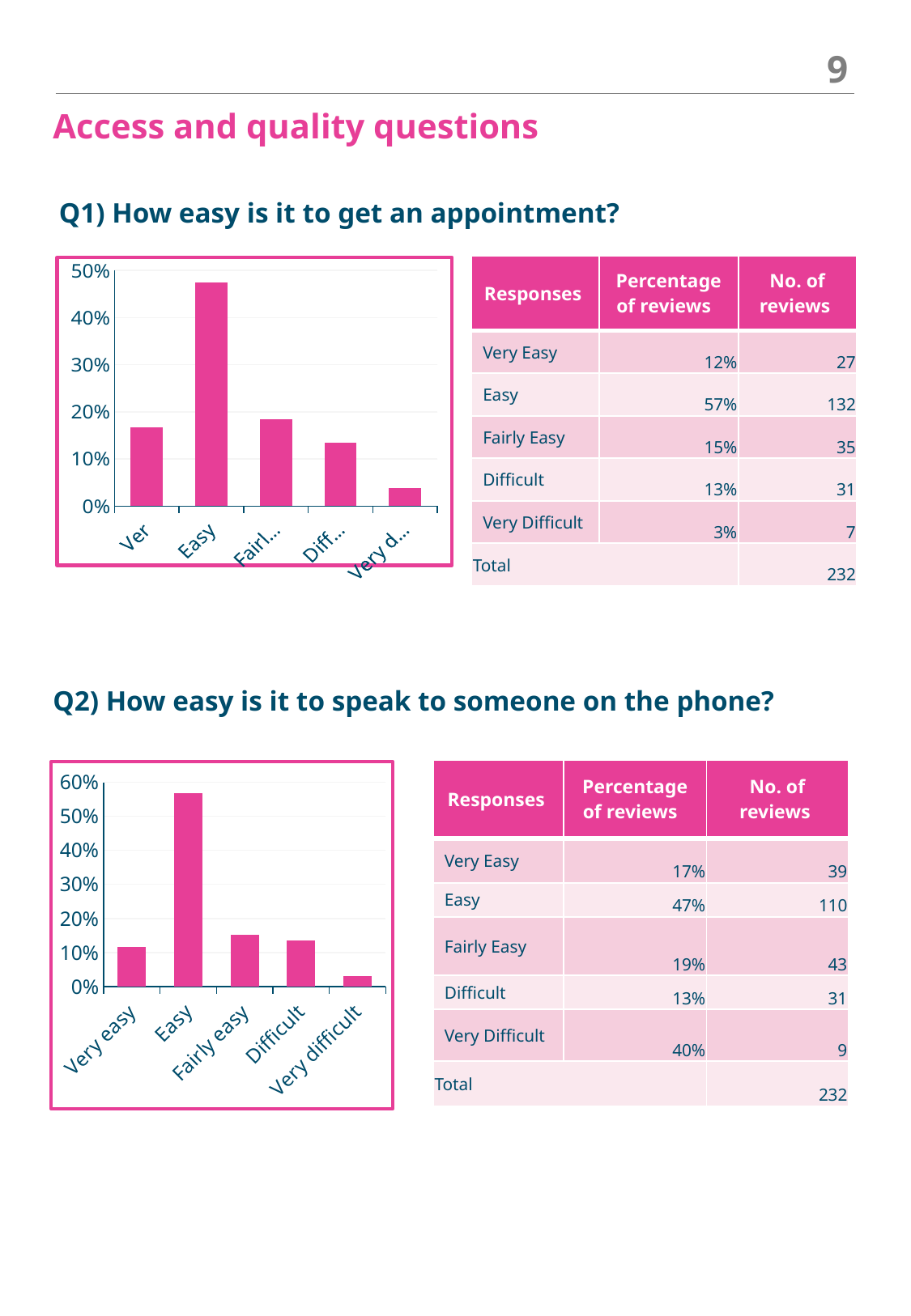
What is the highest value shown on the vertical axis of the Q2) How easy is it to speak to someone on the phone? chart? 60% In the Q1) How easy is it to get an appointment? chart, is the value for Easy greater or less than 40%? greater In the Q2) How easy is it to speak to someone on the phone? chart, which category has the lowest bar? Very difficult In the Q2) How easy is it to speak to someone on the phone? chart, is the value for Easy greater or less than 50%? greater How many bars are plotted in the Q1) How easy is it to get an appointment? chart? 5 In the Q2) How easy is it to speak to someone on the phone? chart, is the value for Fairly easy greater or less than 20%? less In the Q2) How easy is it to speak to someone on the phone? chart, which is larger, the bar for Easy or the bar for Very easy? Easy In the Q2) How easy is it to speak to someone on the phone? chart, which is larger, the bar for Very easy or the bar for Very difficult? Very easy In the Q2) How easy is it to speak to someone on the phone? chart, which category has the highest bar? Easy How many bars are plotted in the Q2) How easy is it to speak to someone on the phone? chart? 5 What kind of chart is shown under Q1) How easy is it to get an appointment? Bar chart